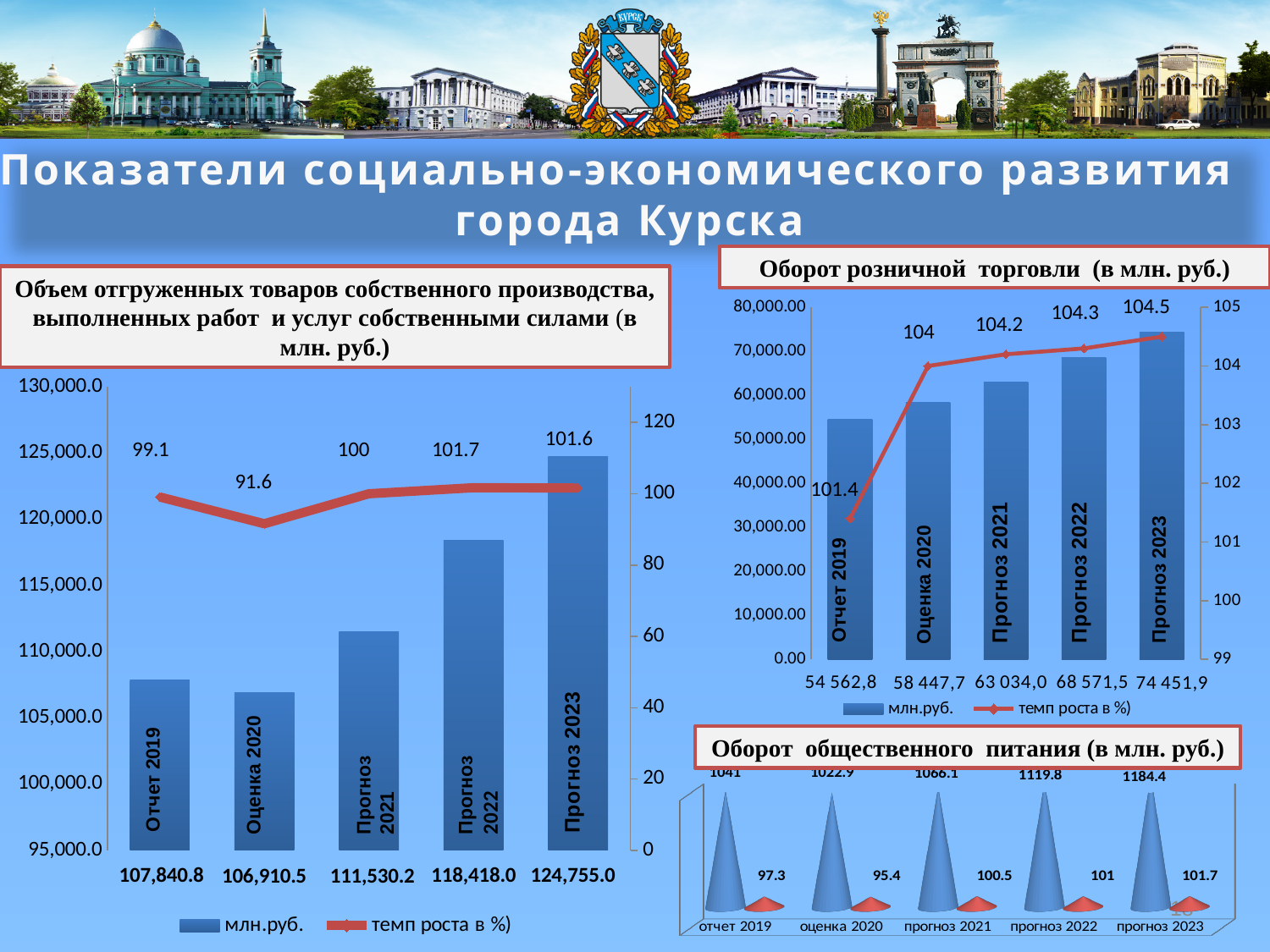
In the chart 'Оборот общественного питания (в млн. руб.)', what is the value for Прогноз 2022? 1119.8 In the chart 'Оборот розничной торговли (в млн. руб.)', which category has the highest value in млн.руб.? Прогноз 2023 In the chart 'Оборот розничной торговли (в млн. руб.)', what is the value for Прогноз 2021? 63 034,0 How many categories are shown in the chart 'Оборот общественного питания (в млн. руб.)'? 5 In the chart 'Объем отгруженных товаров собственного производства...', what is the difference in млн.руб. between Прогноз 2022 and Прогноз 2021? 6,887.8 In the chart 'Объем отгруженных товаров собственного производства...', which category has the lowest value in млн.руб.? Оценка 2020 In the chart 'Объем отгруженных товаров собственного производства...', what is the темп роста в % for Оценка 2020? 91.6 In the chart 'Оборот общественного питания (в млн. руб.)', which category has the lowest growth rate (the small red values)? оценка 2020 In the chart 'Оборот розничной торговли (в млн. руб.)', what is the темп роста в % for Отчет 2019? 101.4 In the chart 'Оборот розничной торговли (в млн. руб.)', do the bar values rise or fall from Отчет 2019 to Прогноз 2023? rise In the chart 'Объем отгруженных товаров собственного производства...', what is the value in млн.руб. for Прогноз 2023? 124,755.0 How many series does the legend of the chart 'Оборот розничной торговли (в млн. руб.)' list? 2